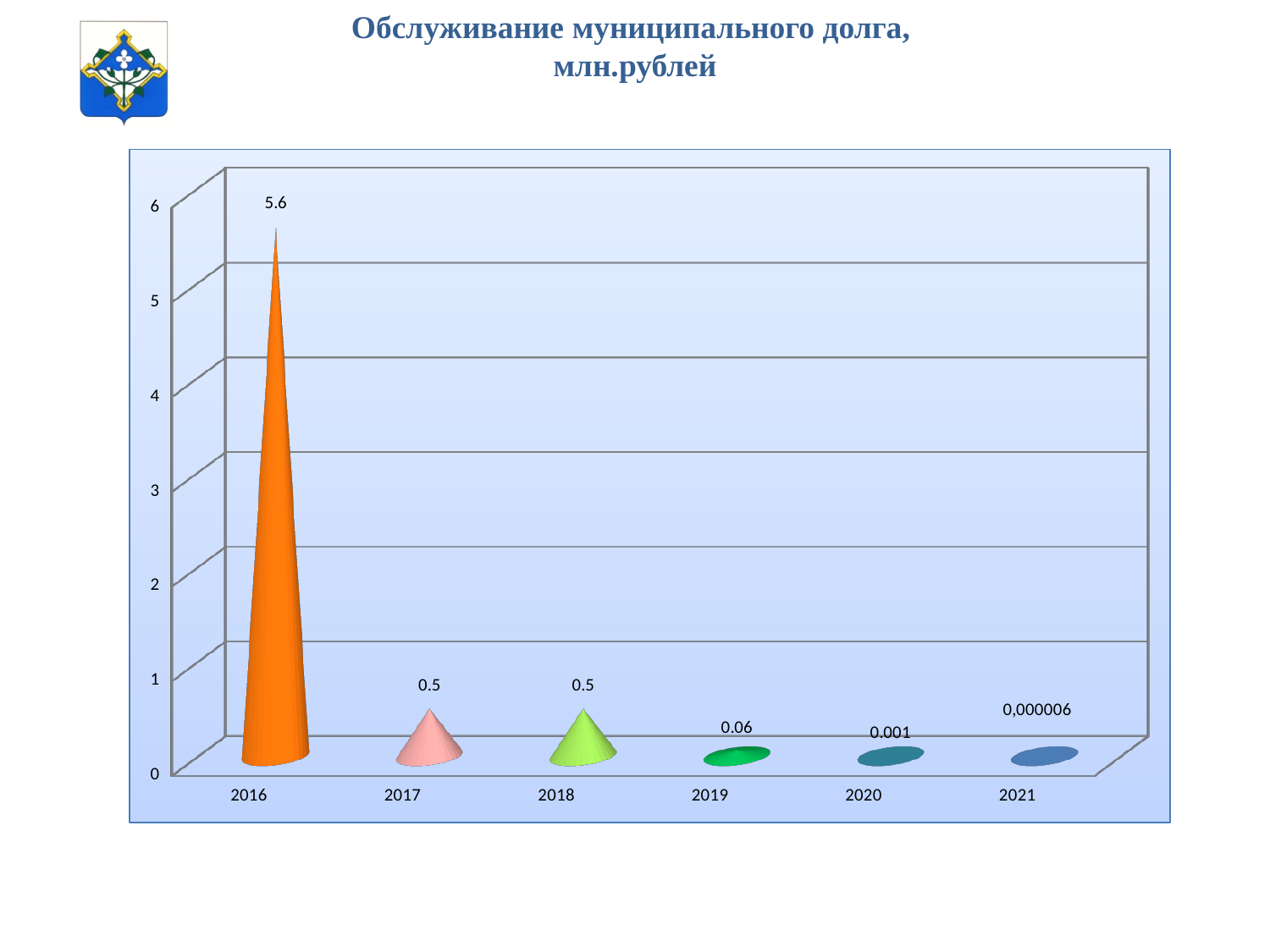
Which is larger, the value for 2018 or the value for 2019? 2018 What is the value for 2016? 5.6 Which year has the highest value? 2016 What is the value for 2021? 0,000006 Do the values rise or fall from 2016 to 2021? fall Which year has the lowest value? 2021 What is the value for 2020? 0.001 What is the difference between the values for 2016 and 2017? 5.1 What is the value for 2019? 0.06 Is the value for 2016 greater or less than 5? greater How many years are shown on the x axis? 6 What is the title of the chart? Обслуживание муниципального долга, млн.рублей